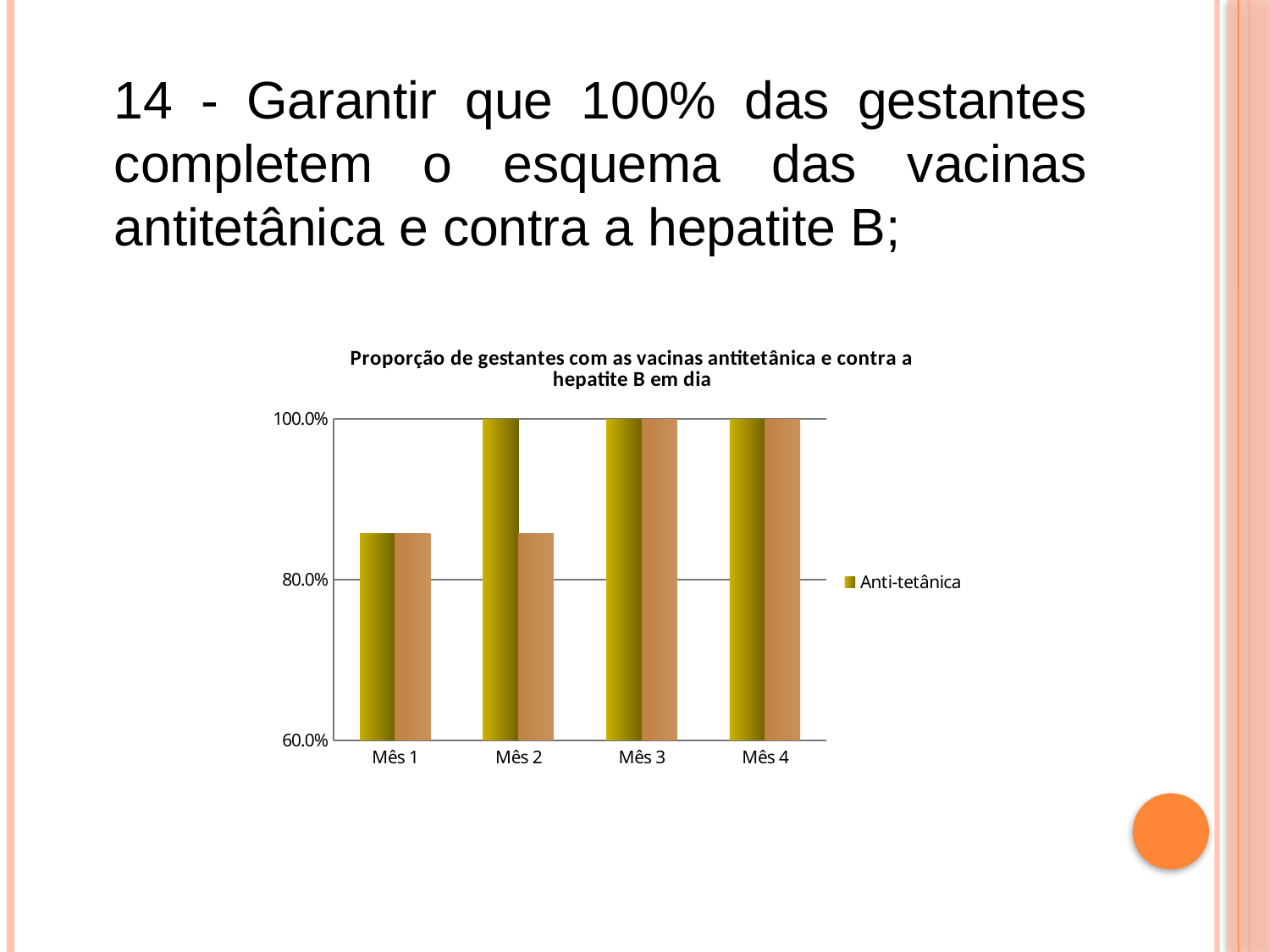
Is the Anti-tetânica value for Mês 1 greater or less than 80.0%? greater What is the Anti-tetânica value for Mês 2? 100.0% What is the Anti-tetânica value for Mês 4? 100.0% Is the Anti-tetânica value for Mês 1 greater or less than 100.0%? less Which has the larger Anti-tetânica value, Mês 1 or Mês 2? Mês 2 In Mês 2, which bar is taller, the Anti-tetânica bar or the orange bar? Anti-tetânica Do the Anti-tetânica values rise or fall from Mês 1 to Mês 4? rise What is the Anti-tetânica value for Mês 3? 100.0% How many series does the chart's legend list? 1 How many categories (months) are shown on the x axis of the chart? 4 What kind of chart is shown on the slide? bar chart What is the title of the chart? Proporção de gestantes com as vacinas antitetânica e contra a hepatite B em dia